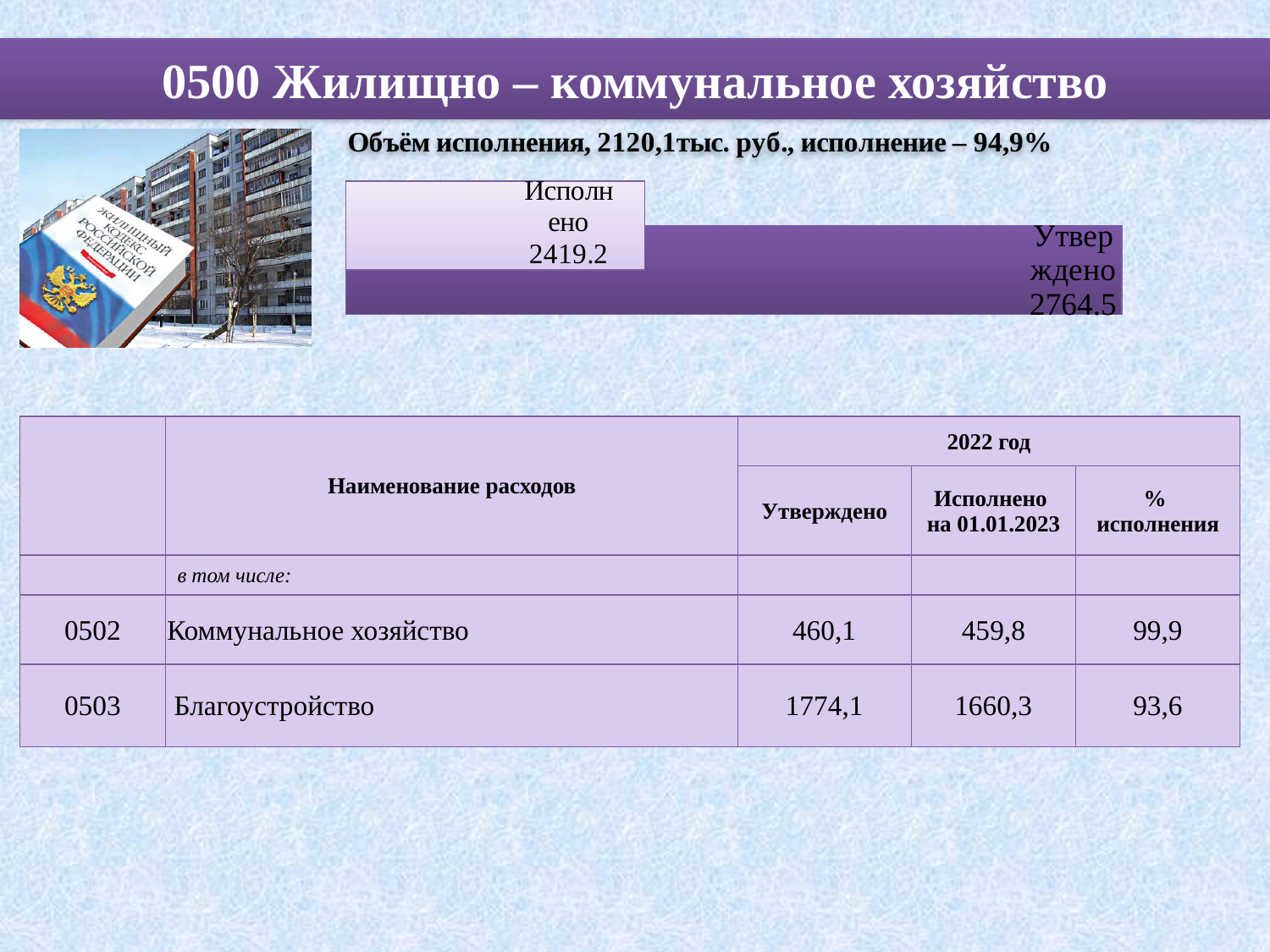
Which bar in the chart is drawn in the darker purple colour? Утверждено What type of chart is shown on the slide? bar chart Which bar in the chart is the shorter one? Исполнено Is the Исполнено value larger or smaller than the Утверждено value in the chart? smaller Which bar in the chart has the higher value? Утверждено What is the value of the Утверждено bar in the chart? 2764.5 Which bar in the chart has the lower value? Исполнено How many bars does the chart show? 2 What is the difference between the Утверждено and Исполнено values in the chart? 345.3 What is the value of the Исполнено bar in the chart? 2419.2